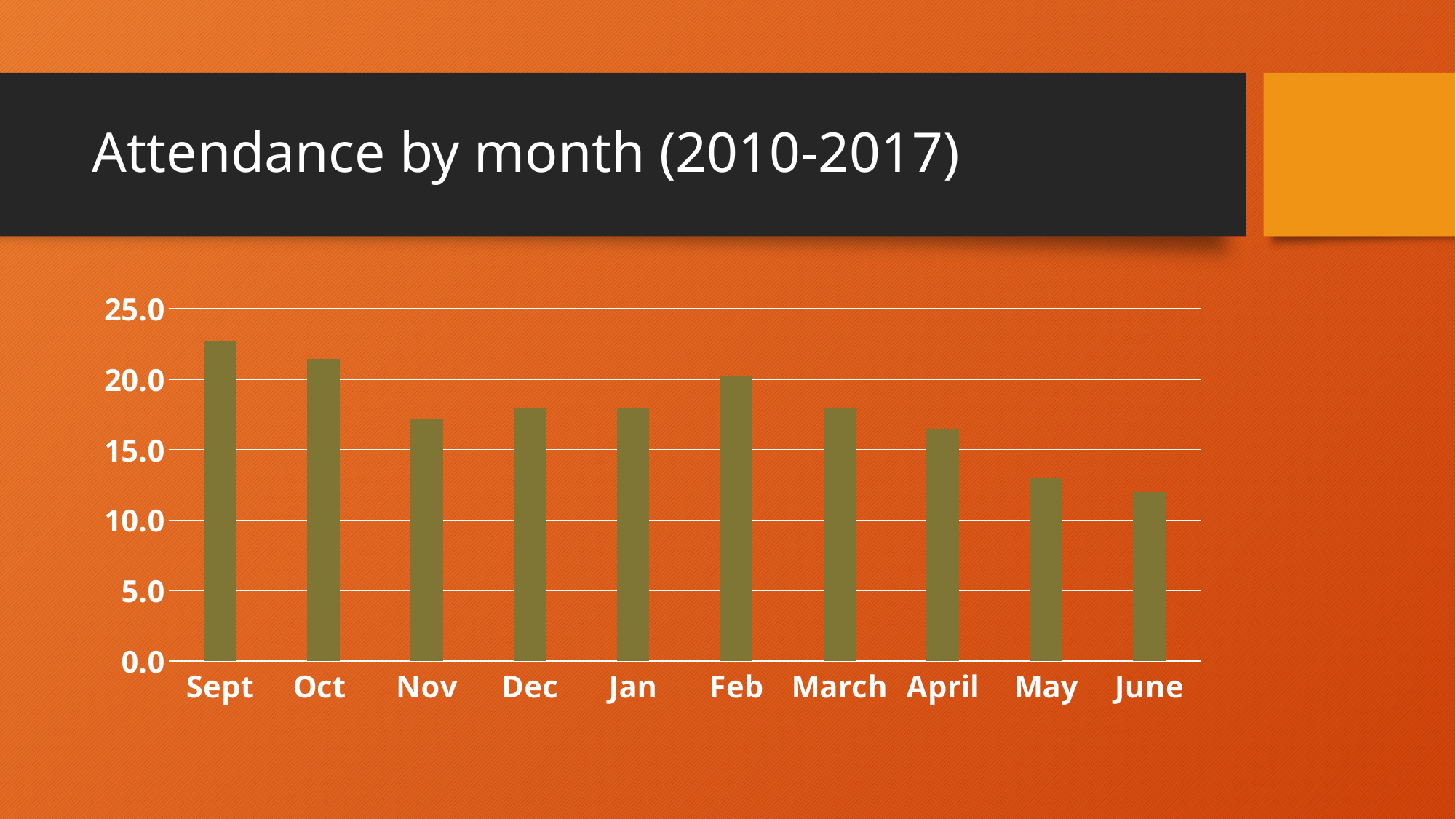
Is the value for June greater or less than 10.0? greater Is the value for May greater or less than 15.0? less Is the value for Nov greater or less than 15.0? greater What kind of chart is shown on the slide? bar chart Do the attendance values generally rise or fall from Sept to June? fall Which month has the highest attendance in the chart? Sept Which has the higher attendance, Feb or Nov? Feb What is the title of the slide containing the chart? Attendance by month (2010-2017) Which month has the lowest attendance in the chart? June How many months are shown on the x axis of the chart? 10